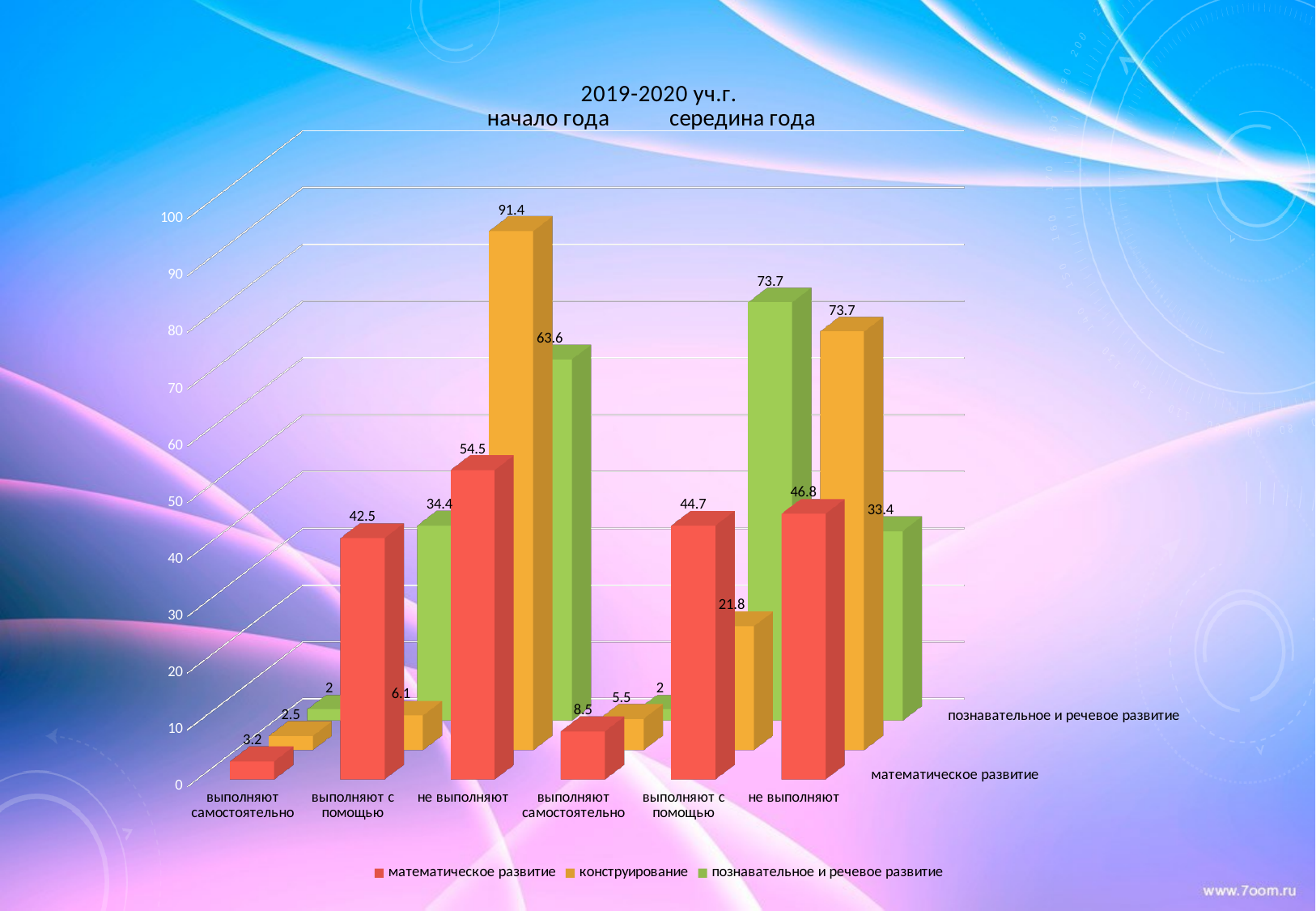
Which series has the lowest value in the 'выполняют с помощью' category at the start of the year (начало года)? конструирование What is the difference between the конструирование values for 'не выполняют' at the start of the year (91.4) and in the middle of the year (73.7)? 17.7 Which series has the highest value in the 'не выполняют' category at the start of the year (начало года)? конструирование How many series does the legend list? 3 What is the value for конструирование in the 'не выполняют' category at the start of the year (начало года)? 91.4 Which is larger: математическое развитие for 'не выполняют' at the start of the year or in the middle of the year? start of the year (54.5) What is the value for математическое развитие in the 'выполняют с помощью' category at the start of the year (начало года)? 42.5 What is the value for математическое развитие in the 'выполняют самостоятельно' category in the middle of the year (середина года)? 8.5 What kind of chart is shown on the slide? bar chart Which colour represents познавательное и речевое развитие in the legend? green How many categories are shown along the x axis? 6 What is the value for познавательное и речевое развитие in the 'выполняют с помощью' category in the middle of the year (середина года)? 73.7